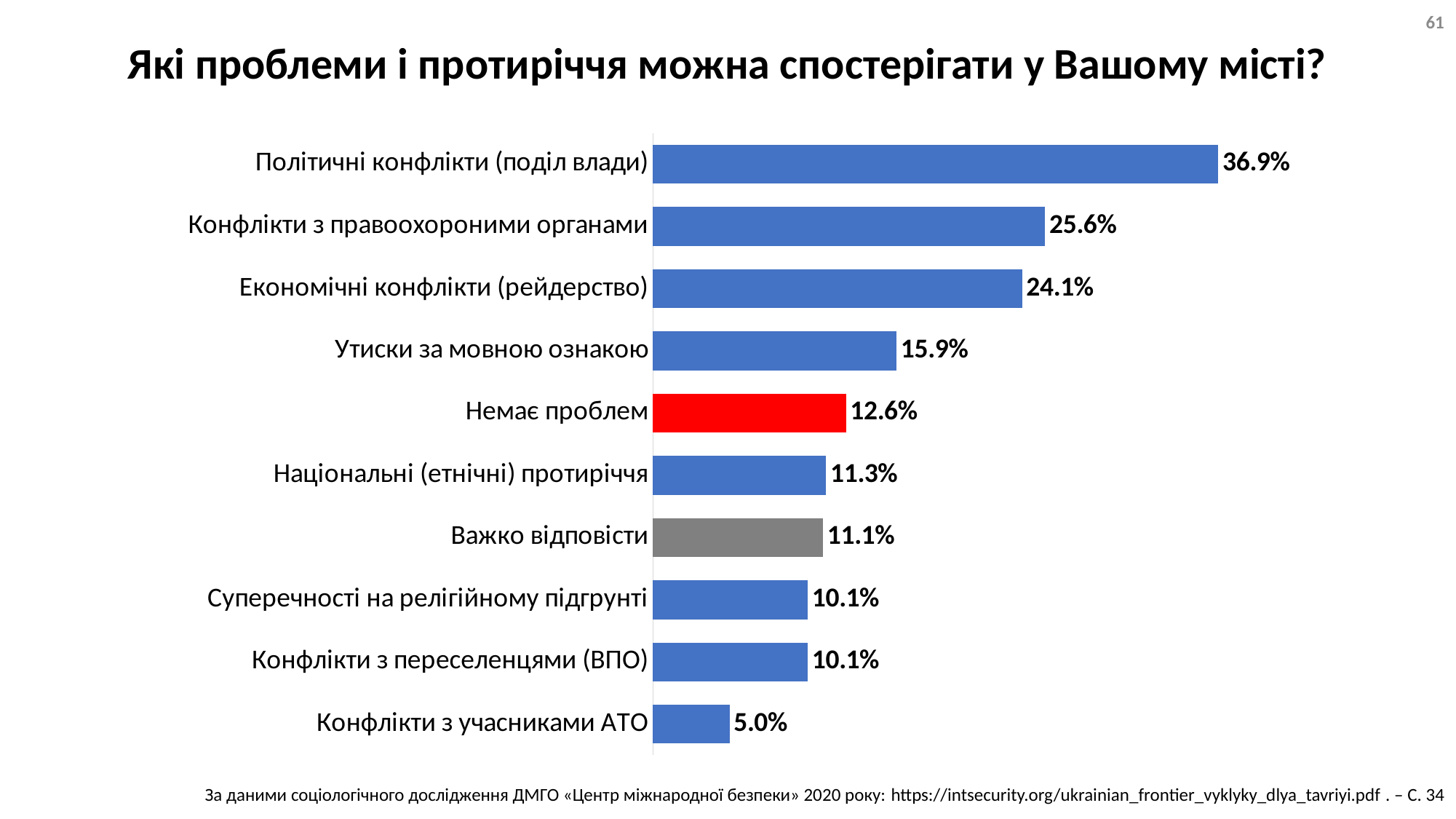
What is the difference between the values for "Утиски за мовною ознакою" and "Немає проблем"? 3.3% Which category has the lowest value? Конфлікти з учасниками АТО Which is larger: the value for "Економічні конфлікти (рейдерство)" or the value for "Утиски за мовною ознакою"? Економічні конфлікти (рейдерство) What is the value for "Утиски за мовною ознакою"? 15.9% Which category's bar is coloured red? Немає проблем What is the value for "Немає проблем"? 12.6% How many categories are shown in the chart? 10 What type of chart is shown on the slide? bar chart What is the value for "Важко відповісти"? 11.1% Which category has the highest value? Політичні конфлікти (поділ влади) What is the value for "Політичні конфлікти (поділ влади)"? 36.9% What is the difference between the values for "Політичні конфлікти (поділ влади)" and "Конфлікти з правоохоронними органами"? 11.3%